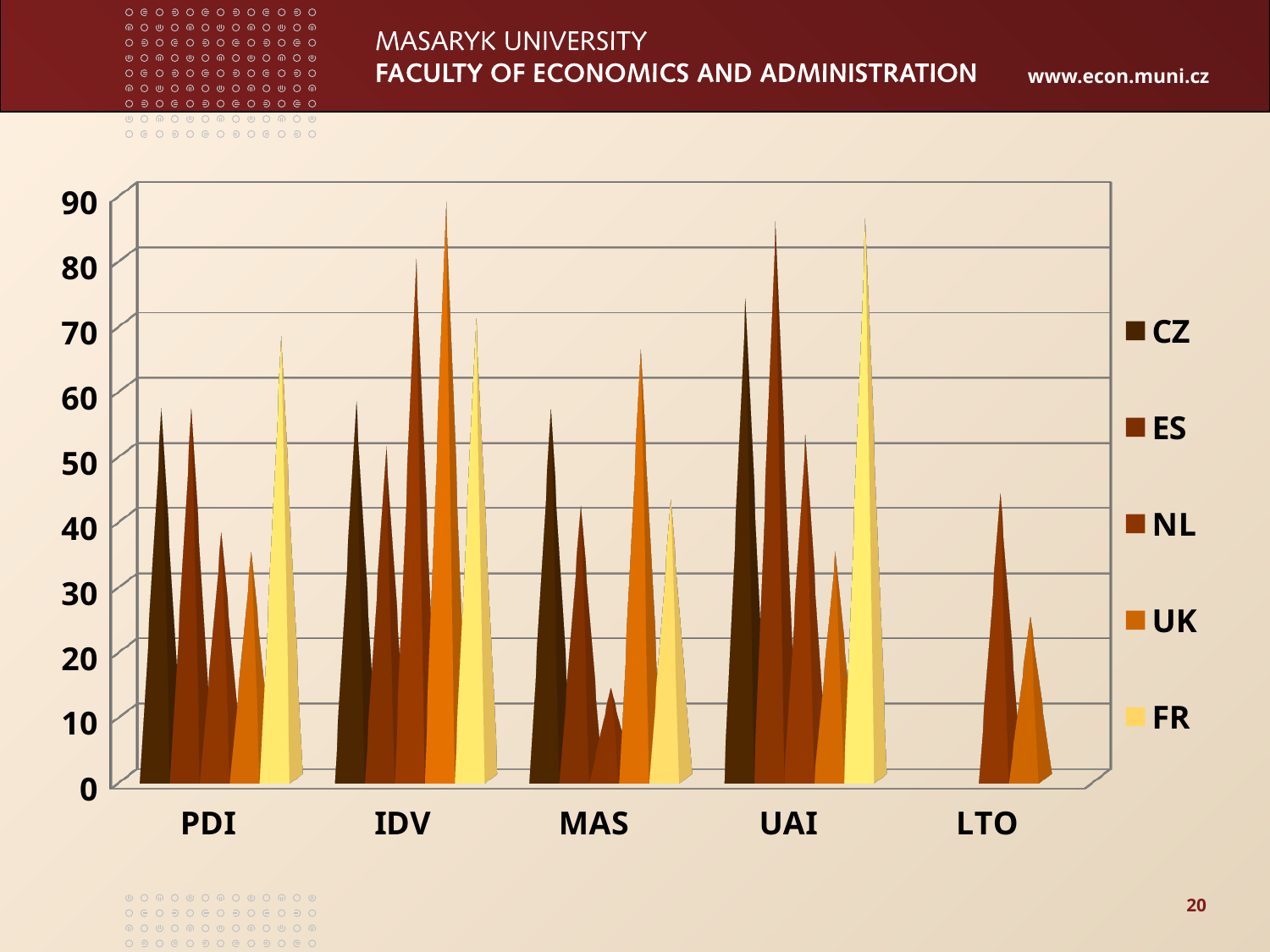
Is the value for NL in the MAS category greater or less than 20? less Which series has the highest value in the IDV category? UK Is the value for UK in the IDV category greater or less than 80? greater How many series does the legend list? 5 In the PDI category, which is larger, the value for CZ or the value for NL? CZ Which series has the highest value in the PDI category? FR What kind of chart is shown on the slide? bar chart Is the value for FR in the PDI category greater or less than 60? greater Which series has the lowest value in the MAS category? NL Which category on the x axis has the fewest bars plotted? LTO How many categories are shown on the x axis? 5